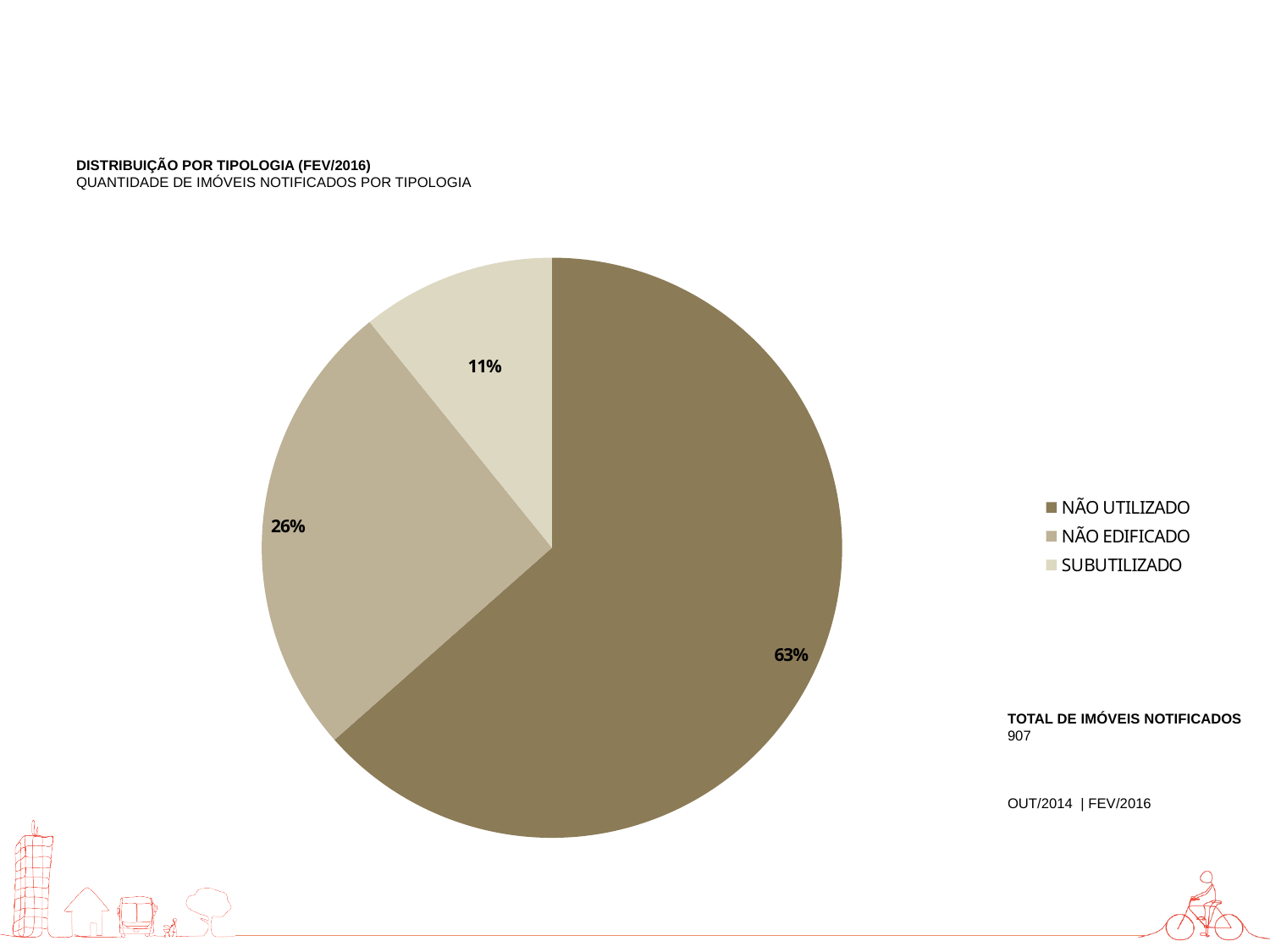
What is the total number of notified properties (TOTAL DE IMÓVEIS NOTIFICADOS) shown on the slide? 907 How many entries does the legend list? 3 What share of the pie does NÃO EDIFICADO represent? 26% What share of the pie does NÃO UTILIZADO represent? 63% What is the difference in percentage points between NÃO EDIFICADO and SUBUTILIZADO? 15 Which category has the largest slice of the pie? NÃO UTILIZADO What is the difference in percentage points between NÃO UTILIZADO and NÃO EDIFICADO? 37 What share of the pie does SUBUTILIZADO represent? 11% What type of chart is shown on the slide? pie chart How many categories does the pie chart have? 3 Which category has the smallest slice of the pie? SUBUTILIZADO Which is larger, the share for NÃO EDIFICADO or the share for SUBUTILIZADO? NÃO EDIFICADO